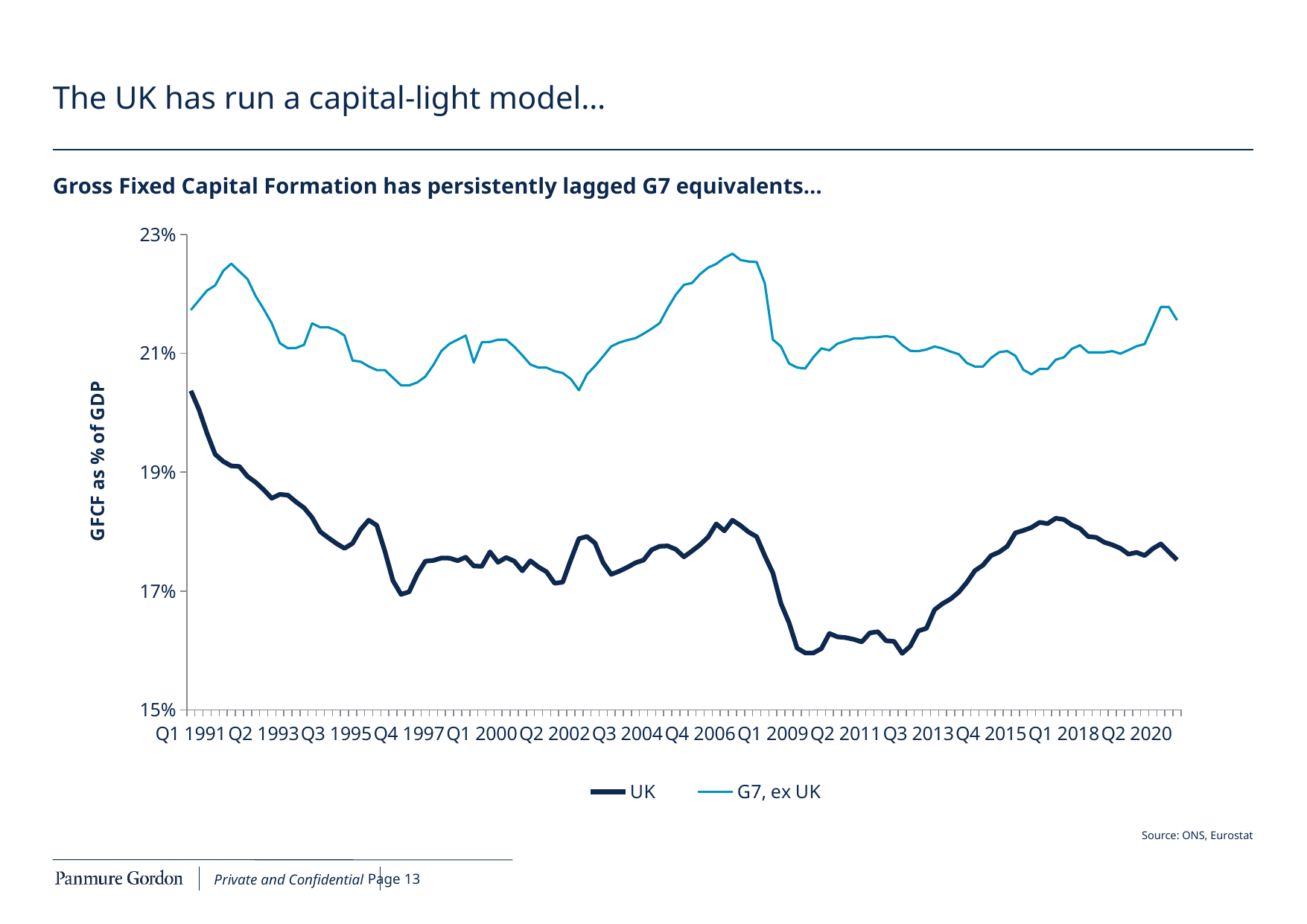
What are the two series named in the legend? UK and G7, ex UK Is the UK value at Q4 2015 greater or less than 19%? less How many series does the legend list? 2 What is the label on the vertical axis of the chart? GFCF as % of GDP Which series has the higher value at Q1 1991, UK or G7, ex UK? G7, ex UK Does the UK series rise or fall between Q3 2013 and Q1 2018? Rise Is the G7, ex UK value at Q1 1991 greater or less than 21%? greater Is the UK value at Q1 1991 greater or less than 19%? greater Does the UK series rise or fall between Q1 1991 and Q4 1997? Fall What kind of chart is shown on the slide? Line chart Which series has the higher value at Q2 2020, UK or G7, ex UK? G7, ex UK